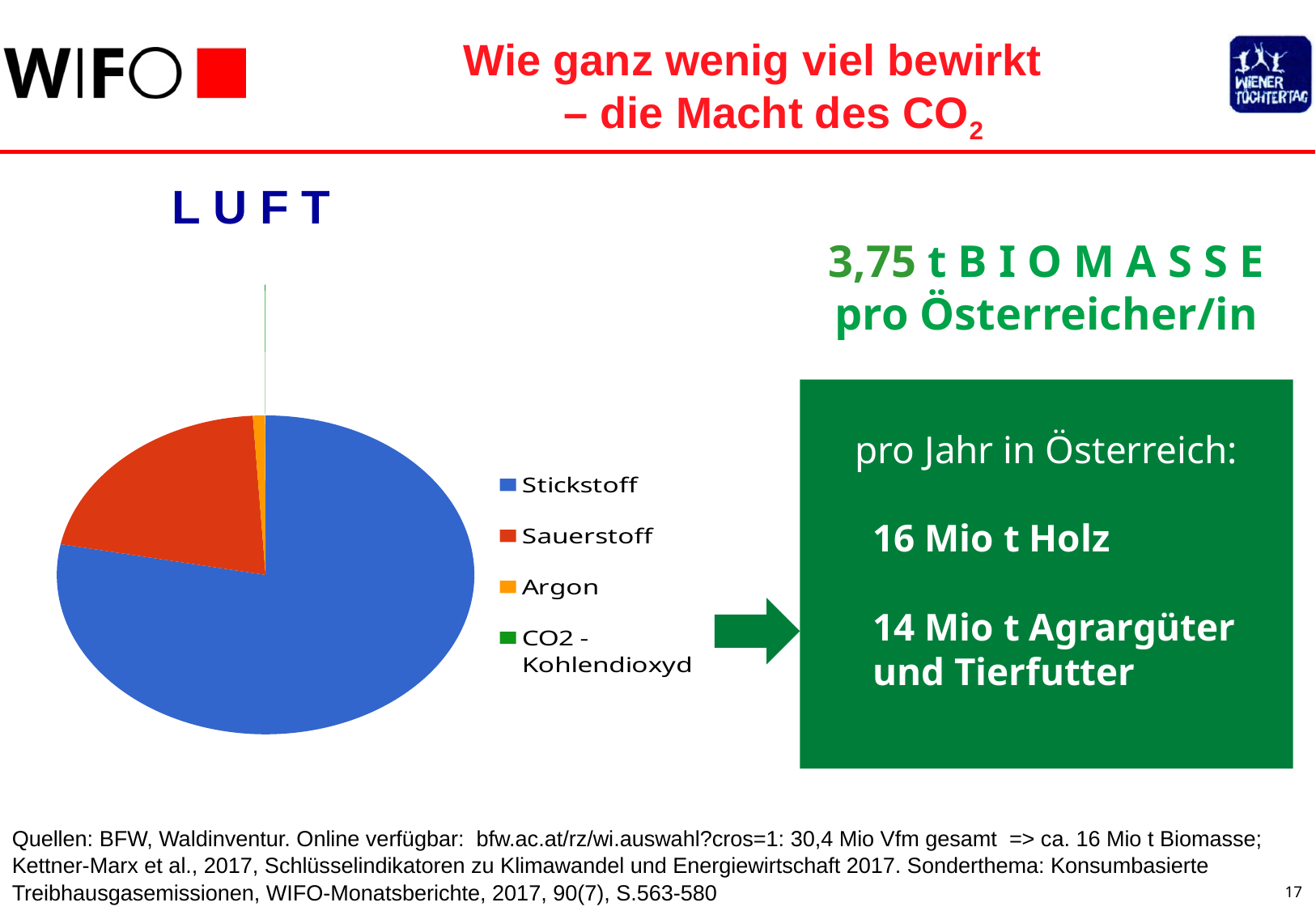
Which slice is larger in the pie chart, Argon or CO2 - Kohlendioxyd? Argon Which category has the largest slice in the pie chart? Stickstoff What colour represents Stickstoff in the pie chart? blue How many categories does the legend of the pie chart list? 4 What kind of chart is shown on the slide? pie chart Which category has the smallest slice in the pie chart? CO2 - Kohlendioxyd Which slice is larger in the pie chart, Stickstoff or Sauerstoff? Stickstoff What is the title of the pie chart? L U F T Which category is the second largest slice in the pie chart? Sauerstoff Which slice is larger in the pie chart, Sauerstoff or Argon? Sauerstoff